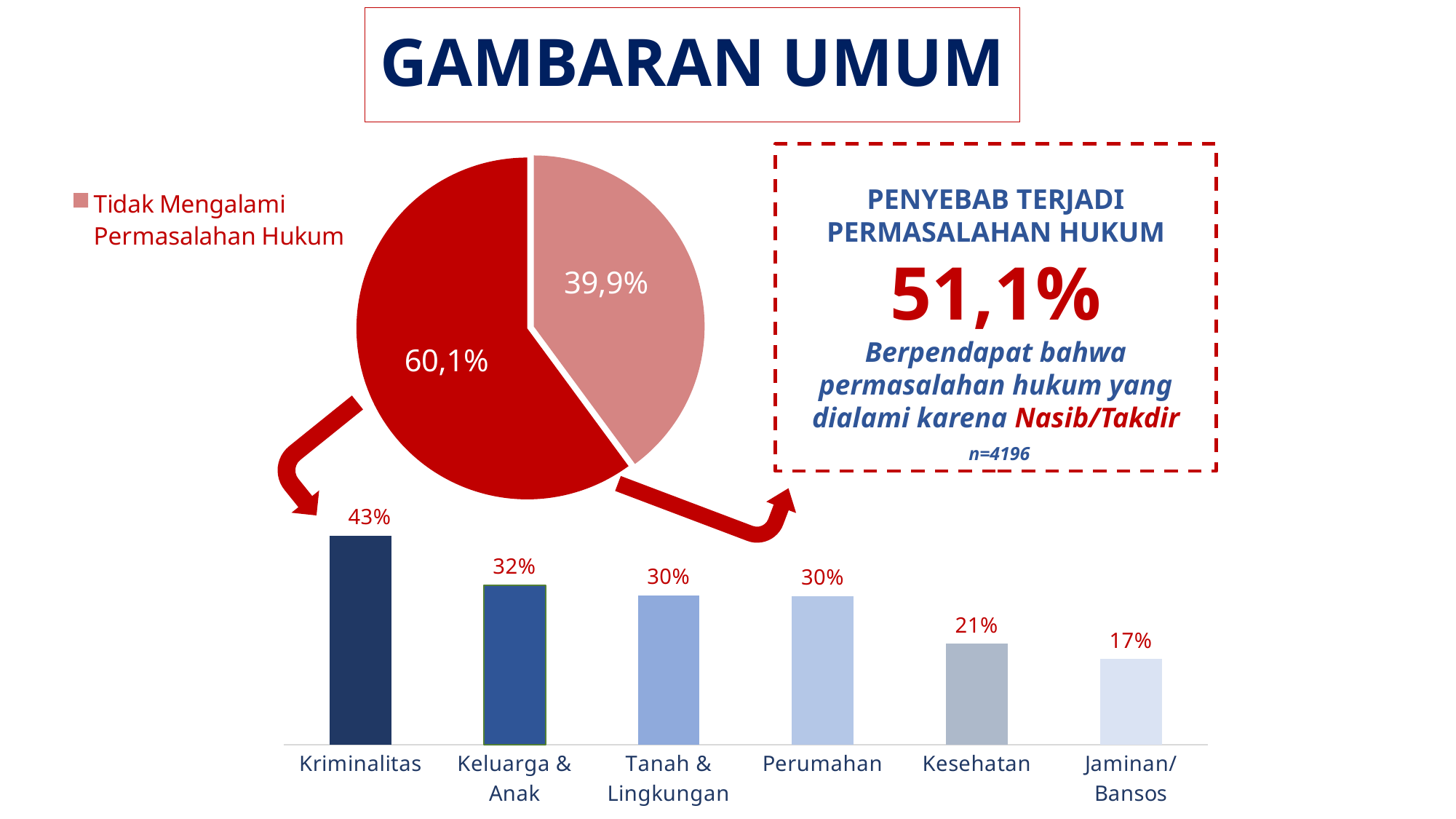
In the pie chart, what share is shown for the slice labelled 'Tidak Mengalami Permasalahan Hukum'? 39,9% How many categories are shown in the bar chart at the bottom? 6 In the bar chart at the bottom, which category has the highest value? Kriminalitas In the bar chart at the bottom, which is larger: the value for Kesehatan or the value for Jaminan/Bansos? Kesehatan In the bar chart at the bottom, which category has the lowest value? Jaminan/Bansos How many slices does the pie chart have? 2 In the bar chart at the bottom, what is the value for Kriminalitas? 43% In the bar chart at the bottom, what is the difference between the values for Kriminalitas and Keluarga & Anak? 11% In the bar chart at the bottom, what is the value for Kesehatan? 21% What kind of chart is the chart at the bottom of the slide? Bar chart In the bar chart at the bottom, do the values rise or fall from left to right? Fall In the pie chart, what value is printed on the larger, dark red slice? 60,1%